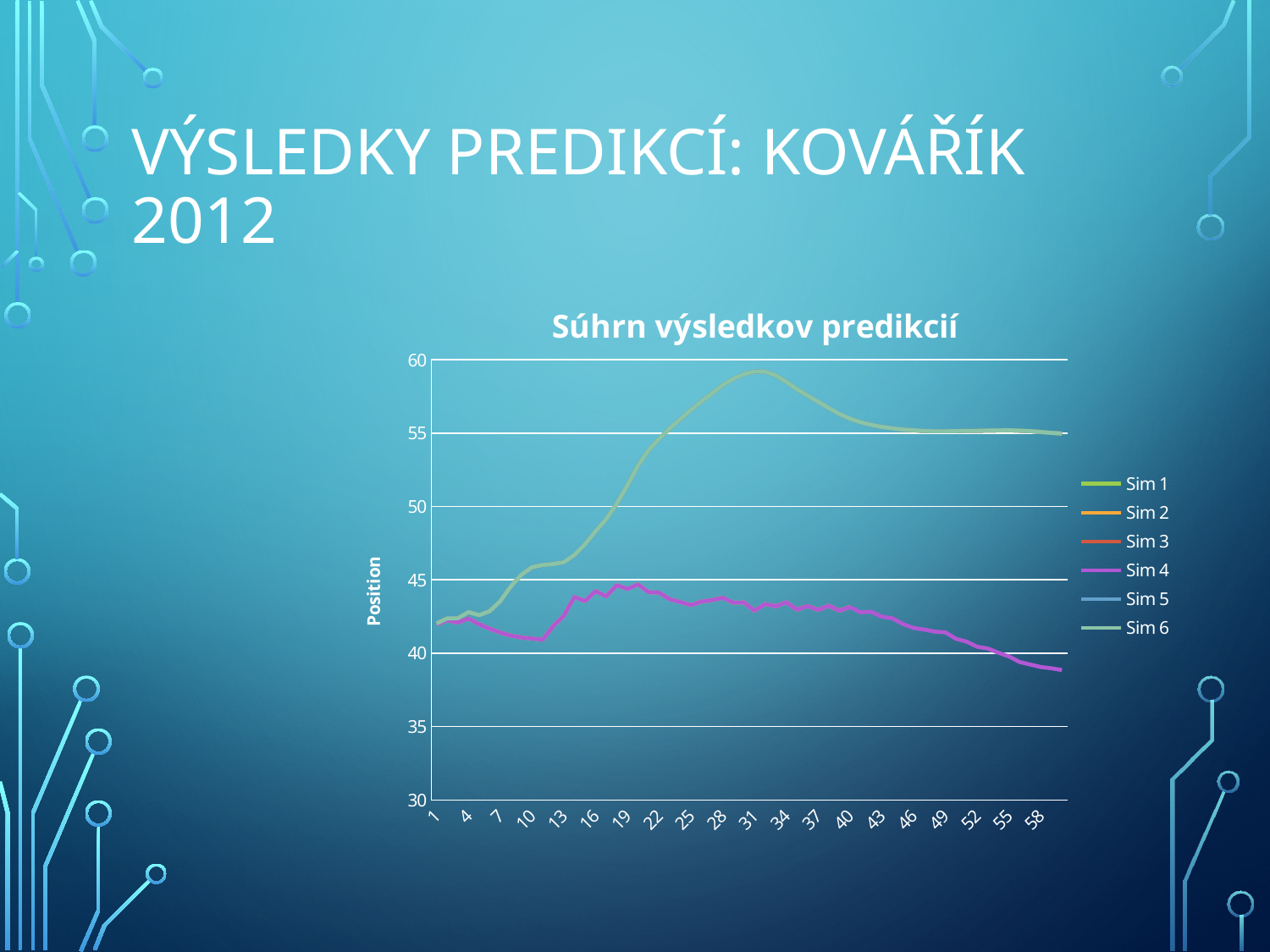
What kind of chart is shown on the slide? line chart Is the value of the Sim 4 (purple) line at x = 40 greater or less than 40? greater Is the value of the Sim 4 (purple) line at x = 58 greater or less than 40? less Is the value of the upper (light green) line at x = 13 greater or less than 50? less How many series does the legend of the chart list? 6 What is the title of the chart? Súhrn výsledkov predikcií Does the Sim 4 (purple) line rise or fall between x = 40 and x = 58? fall What is the label of the vertical axis of the chart? Position Does the upper (light green) line rise or fall between x = 1 and x = 31? rise At x = 31, which line is higher: the upper (light green) line or the Sim 4 (purple) line? the upper (light green) line